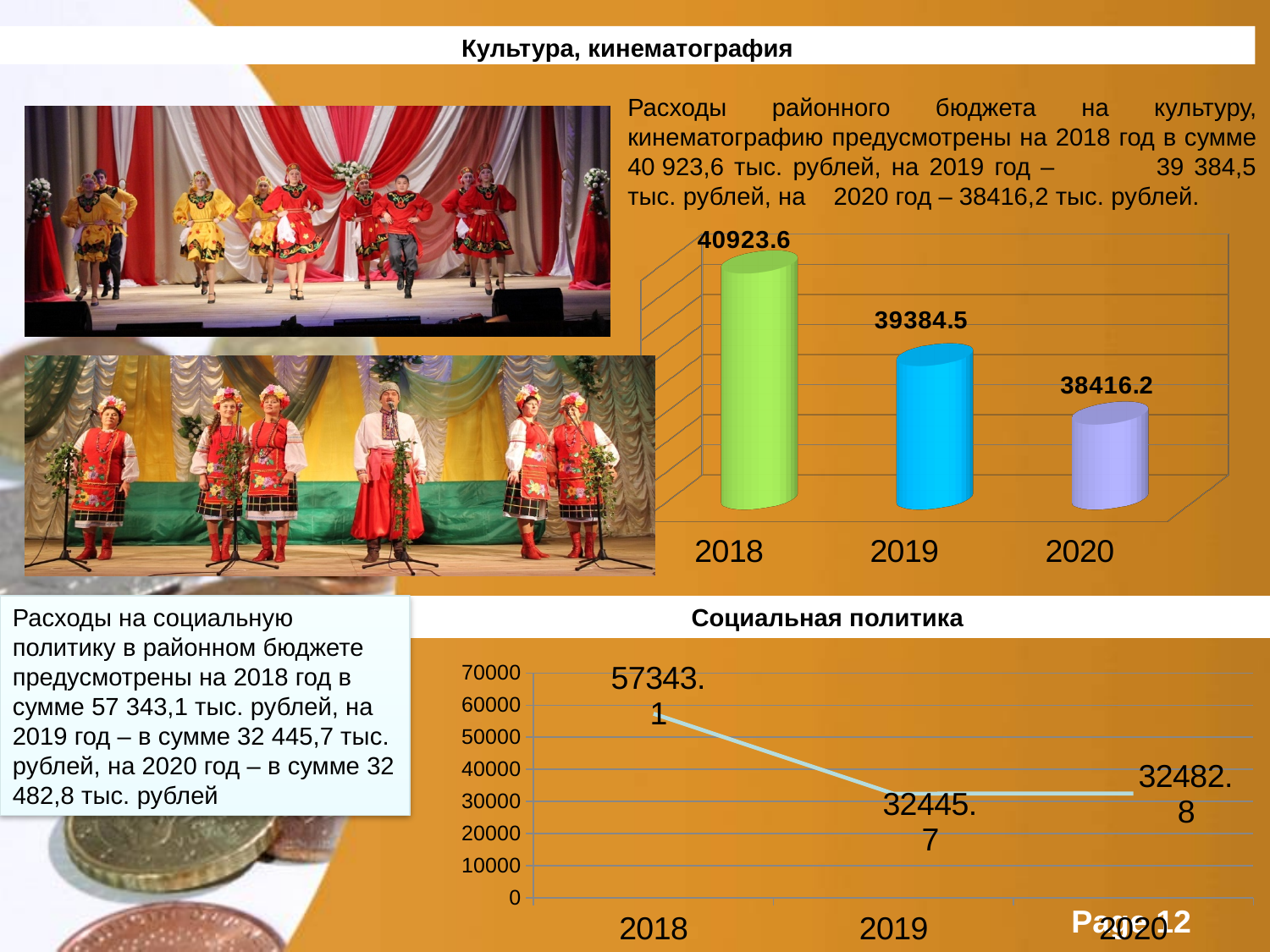
In the line chart titled Социальная политика, what is the value for 2018? 57343.1 In the line chart titled Социальная политика, what is the difference between the 2018 and 2020 values? 24860.3 In the bar chart in the upper right of the slide, what is the value for 2020? 38416.2 What kind of chart is shown in the upper right of the slide? bar chart In the bar chart in the upper right of the slide (Культура, кинематография), what is the value for 2018? 40923.6 How many years are plotted in the line chart titled Социальная политика? 3 In the line chart titled Социальная политика, is the value for 2019 greater or less than 40000? less In the bar chart in the upper right of the slide, which year has the lowest value? 2020 In the line chart titled Социальная политика, what is the value for 2019? 32445.7 In the line chart titled Социальная политика, which year has the highest value? 2018 In the bar chart in the upper right of the slide, do the values rise or fall from 2018 to 2020? fall In the bar chart in the upper right of the slide, what is the difference between the 2018 and 2019 values? 1539.1